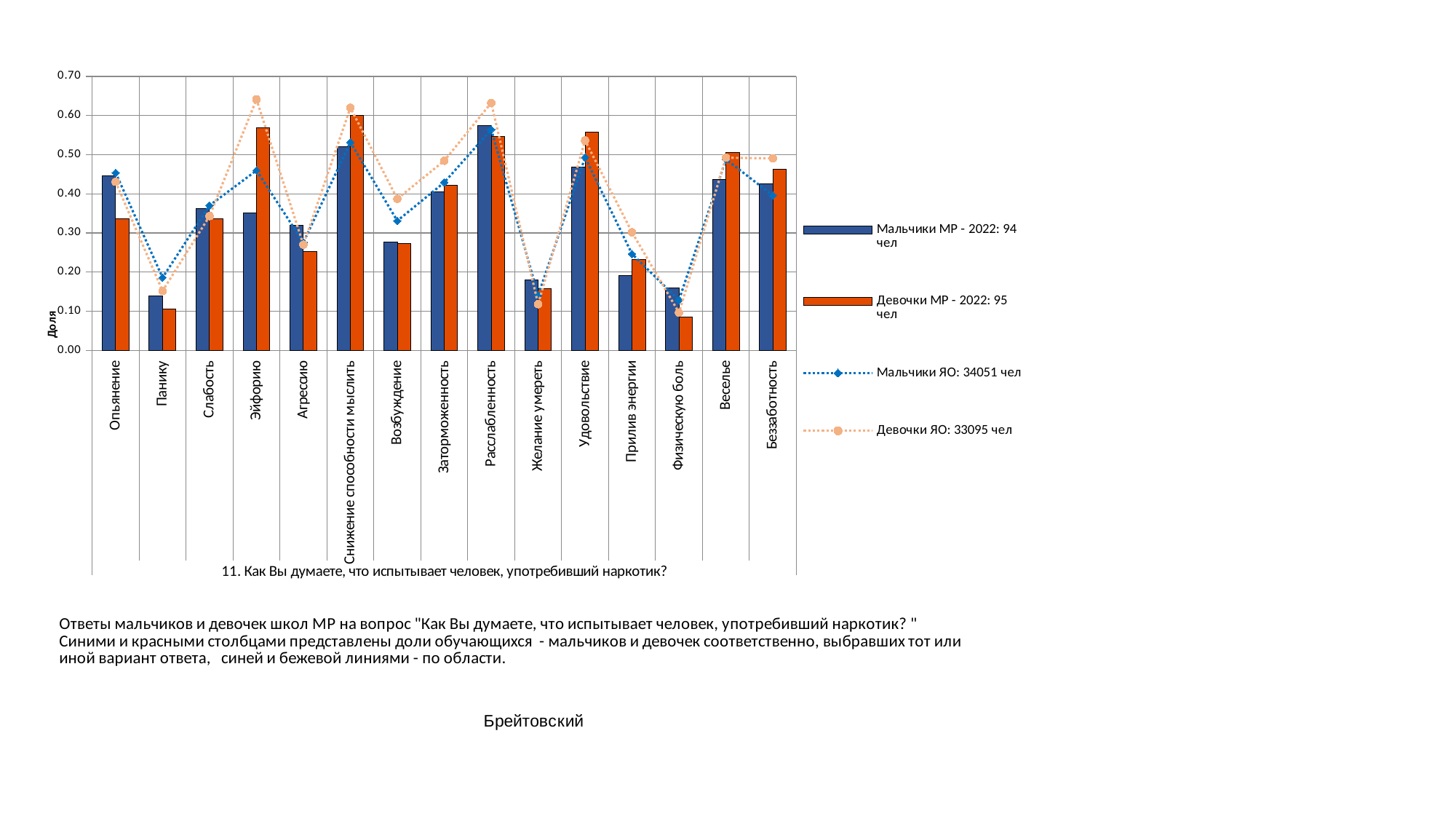
How many series does the chart legend list? 4 Is the value for Эйфорию in the series Девочки МР - 2022: 95 чел greater or less than 0.50? greater What is the label of the vertical axis of the chart? Доля For Эйфорию, which series has the larger value: Мальчики МР - 2022: 94 чел or Девочки МР - 2022: 95 чел? Девочки МР - 2022: 95 чел Which category has the lowest value for the series Девочки МР - 2022: 95 чел? Физическую боль Is the value for Панику in the series Мальчики МР - 2022: 94 чел greater or less than 0.20? less For Опьянение, which series has the larger value: Мальчики МР - 2022: 94 чел or Девочки МР - 2022: 95 чел? Мальчики МР - 2022: 94 чел How many categories are shown on the x axis of the chart? 15 Which category has the highest value for the series Девочки МР - 2022: 95 чел? Снижение способности мыслить What kind of chart is shown on the slide? Bar chart combined with dotted line series Which category has the highest value for the series Мальчики МР - 2022: 94 чел? Расслабленность Is the value for Опьянение in the series Мальчики МР - 2022: 94 чел greater or less than 0.40? greater